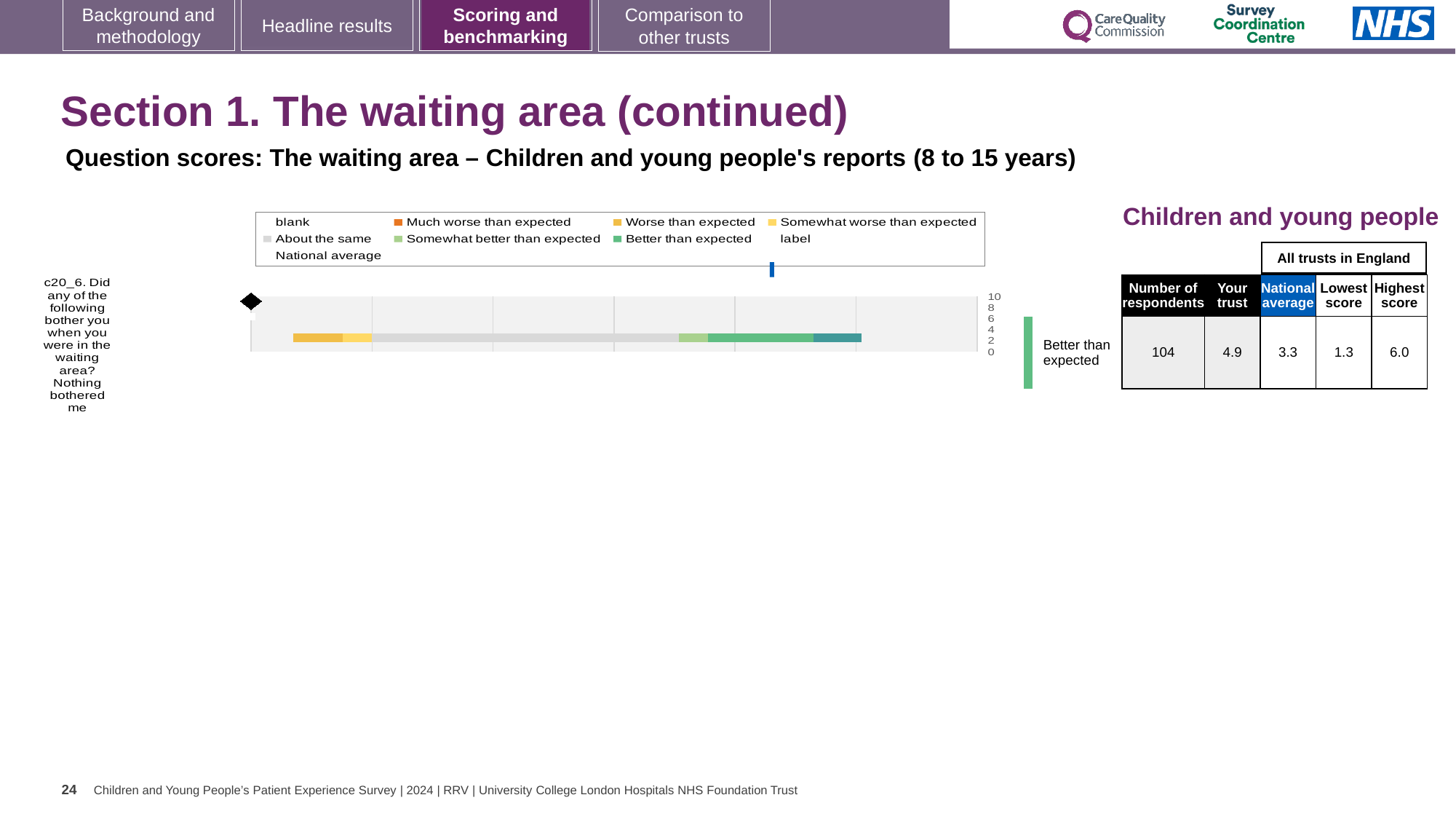
In the table beside the chart, what is the National average score for question c20_6? 3.3 How many questions (categories) are plotted in the chart? 1 What is the difference between the Highest score and the Lowest score for question c20_6? 4.7 What kind of chart is used to show the question score for c20_6? bar chart Which is larger for question c20_6: the 'Your trust' score or the National average? Your trust What is the difference between the 'Your trust' score and the National average for question c20_6? 1.6 What rating label is shown to the right of the bar for question c20_6? Better than expected In the table beside the chart, how many respondents answered question c20_6? 104 In the table beside the chart, what is the Lowest score among all trusts in England? 1.3 What is the highest value shown on the chart's score axis? 10 In the table beside the chart, what is the 'Your trust' score for question c20_6? 4.9 In the table beside the chart, what is the Highest score among all trusts in England? 6.0